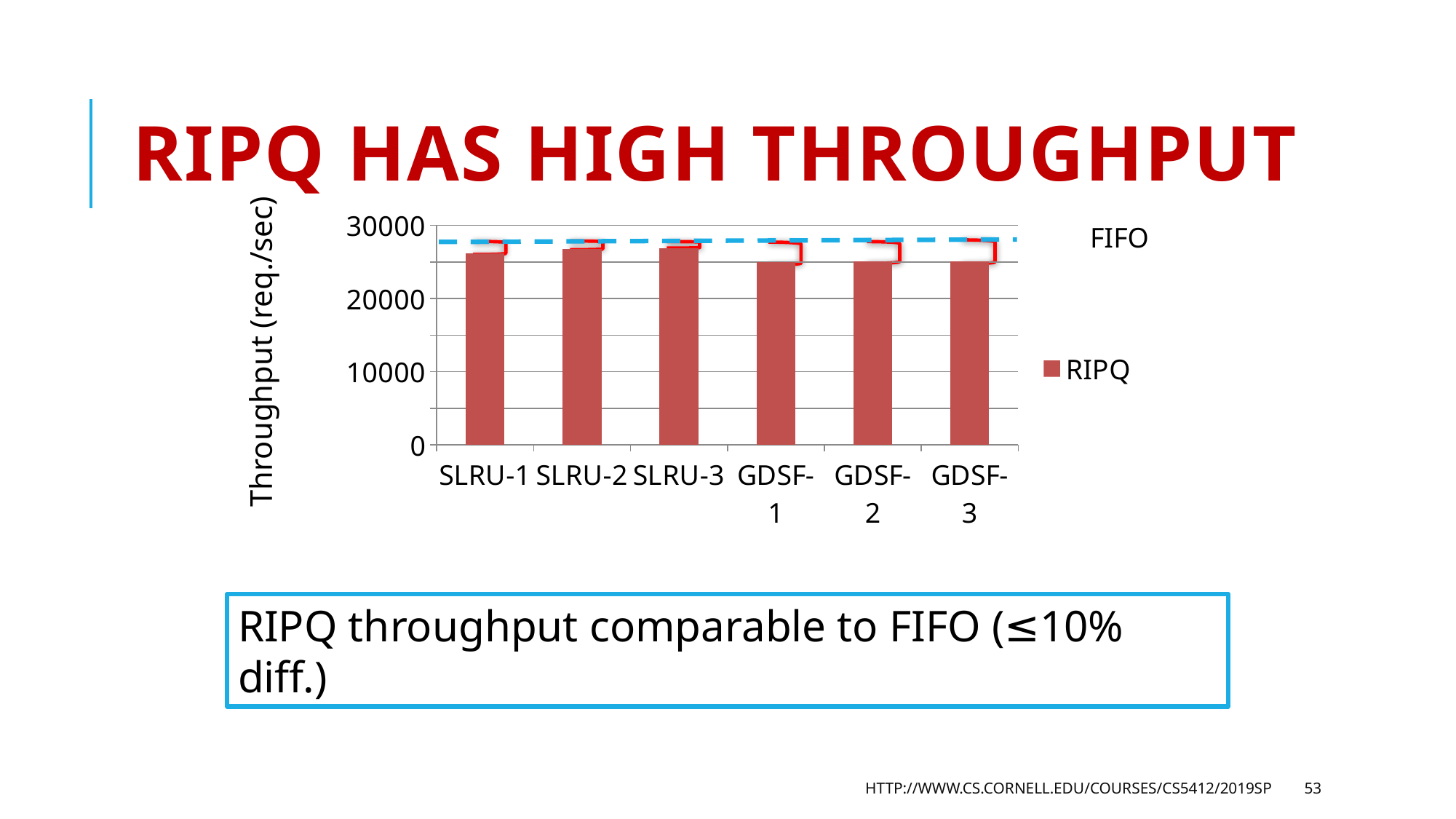
Is the RIPQ value for SLRU-3 greater or less than 30000? less Which has the larger RIPQ throughput, GDSF-2 or SLRU-1? SLRU-1 Are the RIPQ bars for the GDSF categories higher or lower than those for the SLRU categories? lower Is the FIFO dashed line above or below the RIPQ bar for GDSF-2? above Is the RIPQ value for GDSF-1 greater or less than 20000? greater Which has the larger RIPQ throughput, SLRU-2 or GDSF-1? SLRU-2 What does the dashed blue line in the chart represent? FIFO Is the RIPQ value for GDSF-3 greater or less than 30000? less What kind of chart is shown on the slide? bar chart How many categories are shown on the x axis of the chart? 6 What is the label of the y axis of the chart? Throughput (req./sec)